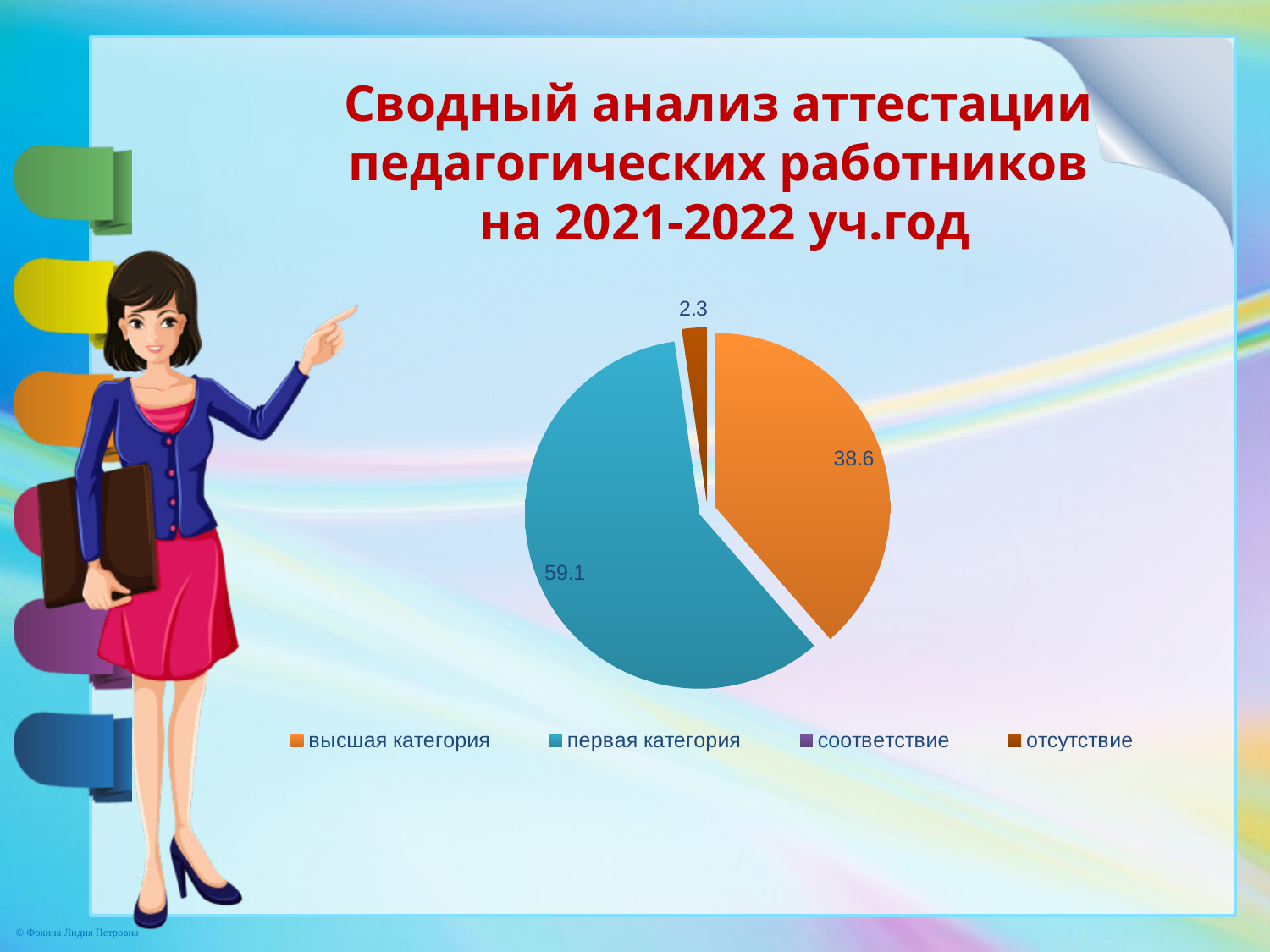
What value is shown for the "отсутствие" slice? 2.3 What is the title of the slide containing the chart? Сводный анализ аттестации педагогических работников на 2021-2022 уч.год Which is larger, the slice for "высшая категория" or the slice for "отсутствие"? высшая категория How many entries does the legend list? 4 How many slices have a data label printed on the pie? 3 What value is shown for the "первая категория" slice? 59.1 What is the difference between the values for "первая категория" and "высшая категория"? 20.5 What colour is the slice for "первая категория"? teal (blue-green) What value is shown for the "высшая категория" slice? 38.6 Which category has the largest slice of the pie? первая категория What kind of chart is shown on the slide? pie chart Which labelled slice of the pie is the smallest? отсутствие